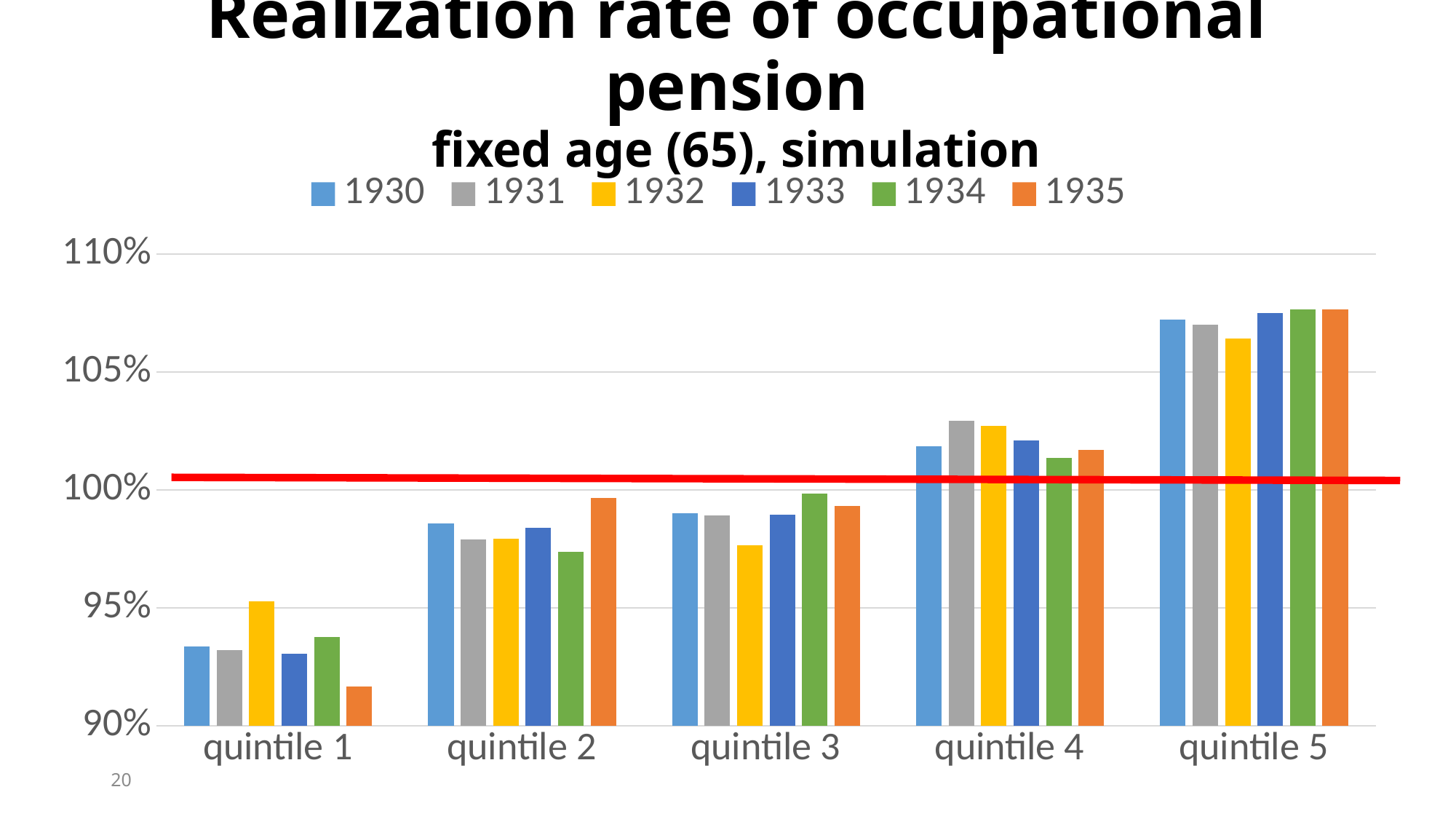
How many series does the legend list? 6 Is the value for 1935 in quintile 1 greater or less than 95%? less Is the value for 1931 in quintile 4 greater or less than 100%? greater Which year has the highest value in quintile 1? 1932 Which year has the lowest value in quintile 1? 1935 How many quintile categories are shown on the x axis? 5 What kind of chart is shown on the slide? bar chart Is the value for 1932 in quintile 3 greater or less than 100%? less Which year has the lowest value in quintile 3? 1932 In quintile 4, which is larger: the value for 1931 or the value for 1934? 1931 Which year has the highest value in quintile 2? 1935